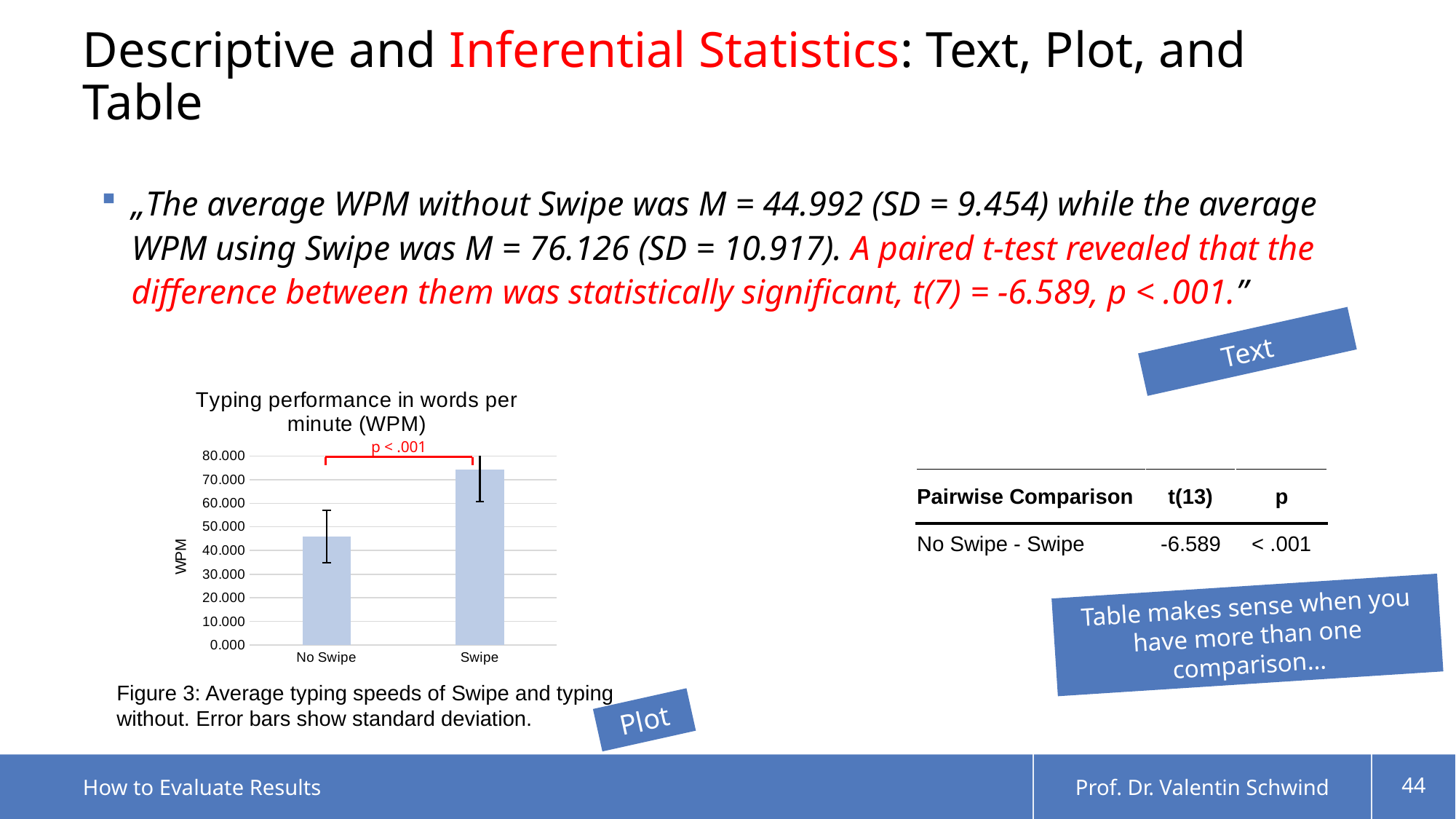
Is the value for No Swipe greater or less than 50.000? less What kind of chart is shown on the slide? bar chart Which bar is taller, No Swipe or Swipe? Swipe How many categories are plotted on the x axis of the chart? 2 Is the value for Swipe greater or less than 80.000? less What is the label on the y axis of the chart? WPM Which category has the highest bar in the chart? Swipe What is the title of the chart? Typing performance in words per minute (WPM) Which category has the lowest bar in the chart? No Swipe Do the bar values rise or fall going from No Swipe to Swipe along the x axis? rise Is the value for No Swipe greater or less than 40.000? greater